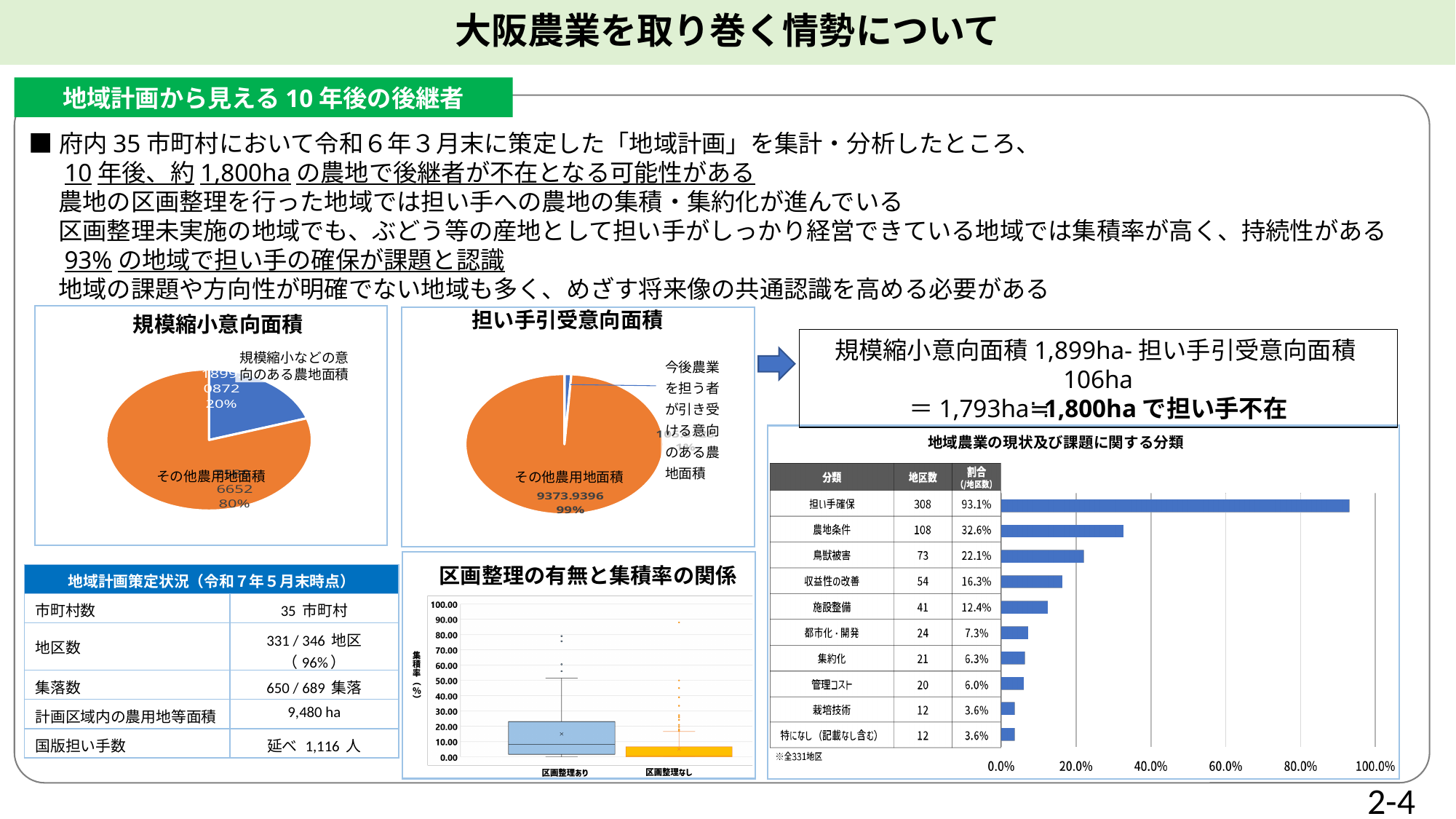
How many categories are shown in the bar chart titled 地域農業の現状及び課題に関する分類? 10 In the bar chart titled 地域農業の現状及び課題に関する分類, which has the larger 割合: 施設整備 or 都市化・開発? 施設整備 In the bar chart titled 地域農業の現状及び課題に関する分類, which category has the highest 割合? 担い手確保 In the chart titled 区画整理の有無と集積率の関係, which group has the higher 集積率 box: 区画整理あり or 区画整理なし? 区画整理あり In the bar chart titled 地域農業の現状及び課題に関する分類, what is the difference in 割合 between 農地条件 and 鳥獣被害? 10.5% What kind of chart is the one titled 規模縮小意向面積? pie chart What kind of chart is the one titled 地域農業の現状及び課題に関する分類? bar chart In the pie chart titled 担い手引受意向面積, what share does その他農用地面積 have? 99% What kind of chart is the one titled 区画整理の有無と集積率の関係? box plot In the bar chart titled 地域農業の現状及び課題に関する分類, what is the 割合 for 担い手確保? 93.1% In the pie chart titled 担い手引受意向面積, what value is labelled for その他農用地面積? 9373.9396 In the pie chart titled 規模縮小意向面積, what share does その他農用地面積 have? 80%